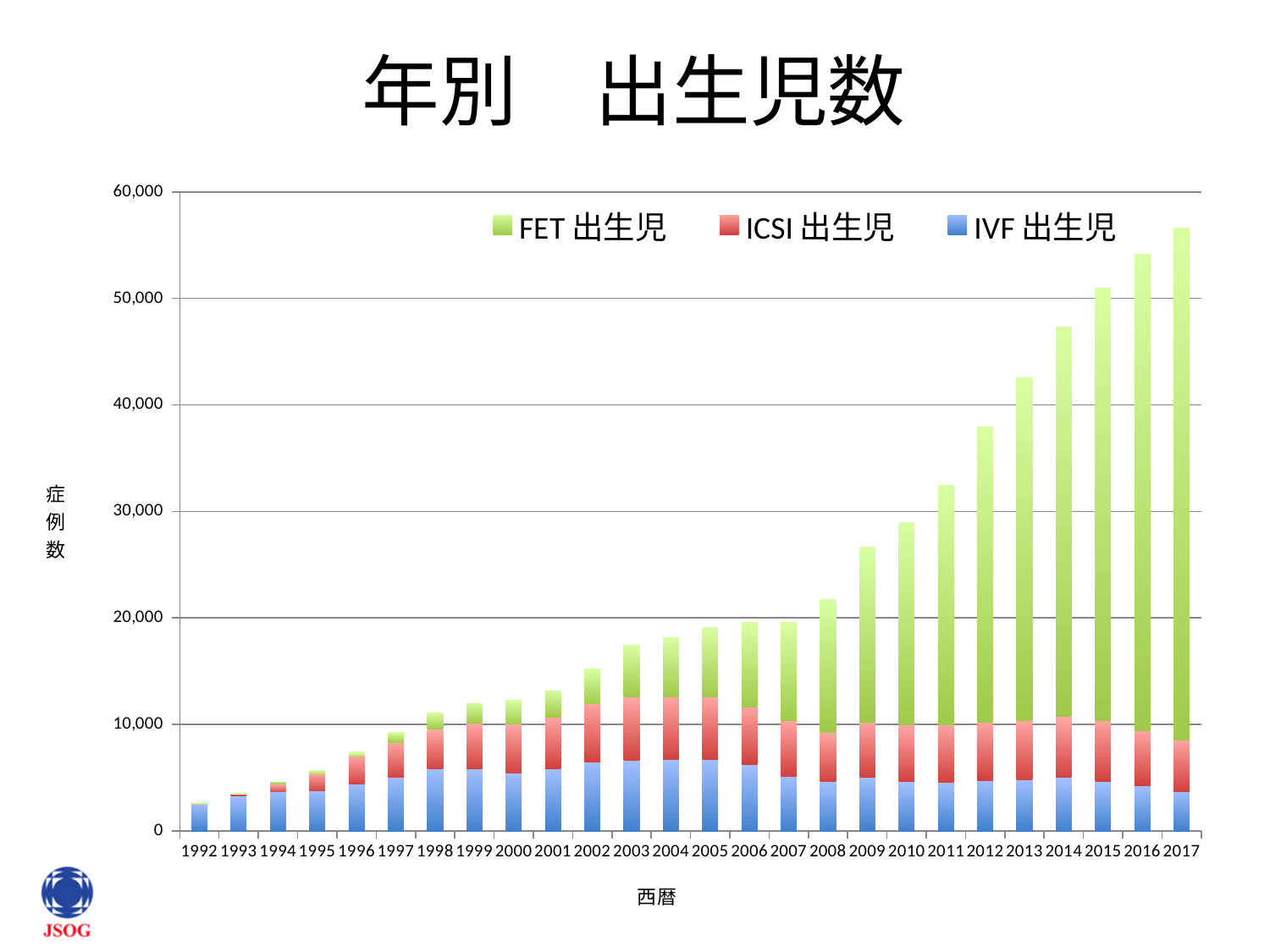
Which year has the lowest total number of births? 1992 What is the title of the chart? 年別 出生児数 Is the total value for 2008 greater or less than 20,000? greater Which year has the highest total number of births? 2017 How many years are shown along the x axis? 26 Do the total bar heights rise or fall from 1992 to 2017? rise What kind of chart is shown on the slide? bar chart How many series does the legend list? 3 Which year has a larger total, 2015 or 2016? 2016 Is the total value for 1996 greater or less than 10,000? less Which series is shown in green in the legend? FET 出生児 Is the total value for 2017 greater or less than 50,000? greater